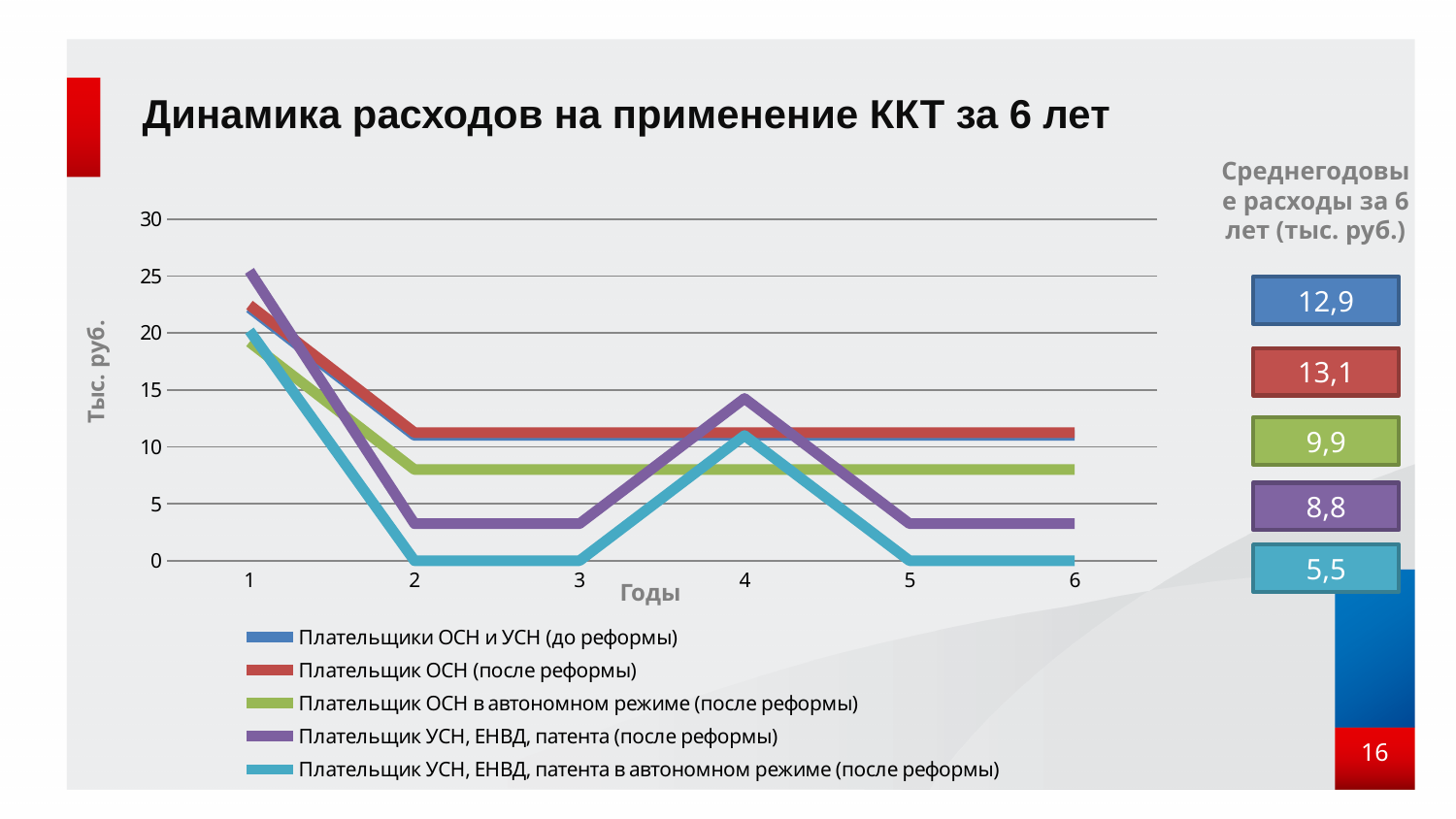
Is the value for 'Плательщик УСН, ЕНВД, патента в автономном режиме (после реформы)' in year 2 greater or less than 5? less What is the label of the y axis? Тыс. руб. Which series has the highest value in year 1? Плательщик УСН, ЕНВД, патента (после реформы) What kind of chart is shown on the slide? line chart Which series has the lowest value in year 2? Плательщик УСН, ЕНВД, патента в автономном режиме (после реформы) Does the value for 'Плательщик УСН, ЕНВД, патента в автономном режиме (после реформы)' rise or fall from year 1 to year 2? fall What is the title of the chart? Динамика расходов на применение ККТ за 6 лет In year 2, which is larger: the value for 'Плательщик ОСН в автономном режиме (после реформы)' or for 'Плательщик УСН, ЕНВД, патента (после реформы)'? Плательщик ОСН в автономном режиме (после реформы) How many series does the legend list? 5 How many years (points) are plotted along the x axis? 6 Is the value for 'Плательщик ОСН в автономном режиме (после реформы)' in year 3 greater or less than 5? greater Is the value for 'Плательщик УСН, ЕНВД, патента (после реформы)' in year 1 greater or less than 20? greater